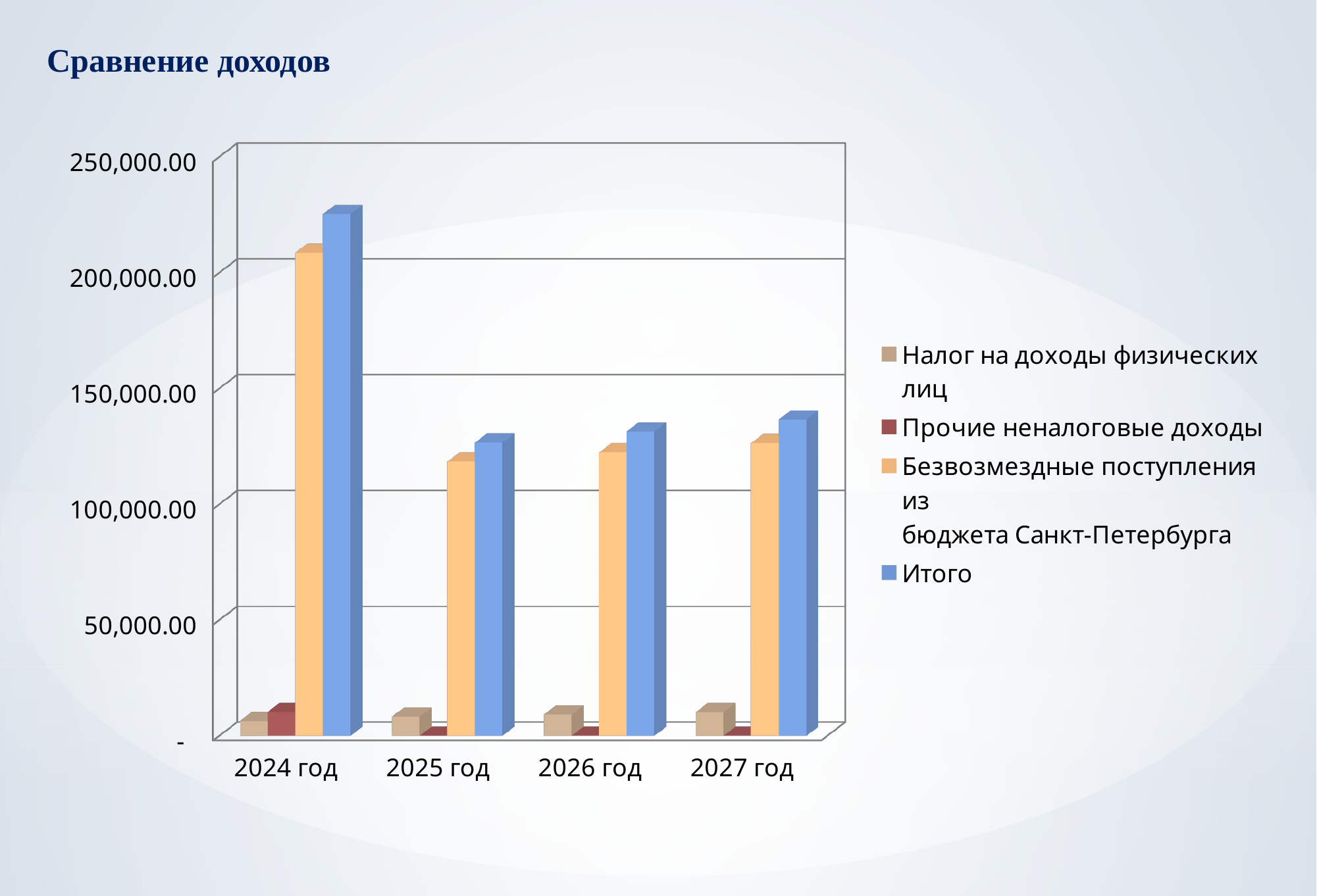
How many series does the legend list? 4 Which series is shown in blue in the legend? Итого Is the value for Итого in 2025 год greater or less than 150,000.00? less Is the value for Итого in 2024 год greater or less than 200,000.00? greater Is the value for Налог на доходы физических лиц in 2027 год greater or less than 50,000.00? less What is the title of the chart? Сравнение доходов Which is larger: Итого in 2024 год or Итого in 2025 год? Итого in 2024 год Do the values for Итого rise or fall from 2025 год to 2027 год? rise What kind of chart is shown on the slide? bar chart How many year categories are shown on the x axis? 4 In which year is the value for Итого highest? 2024 год